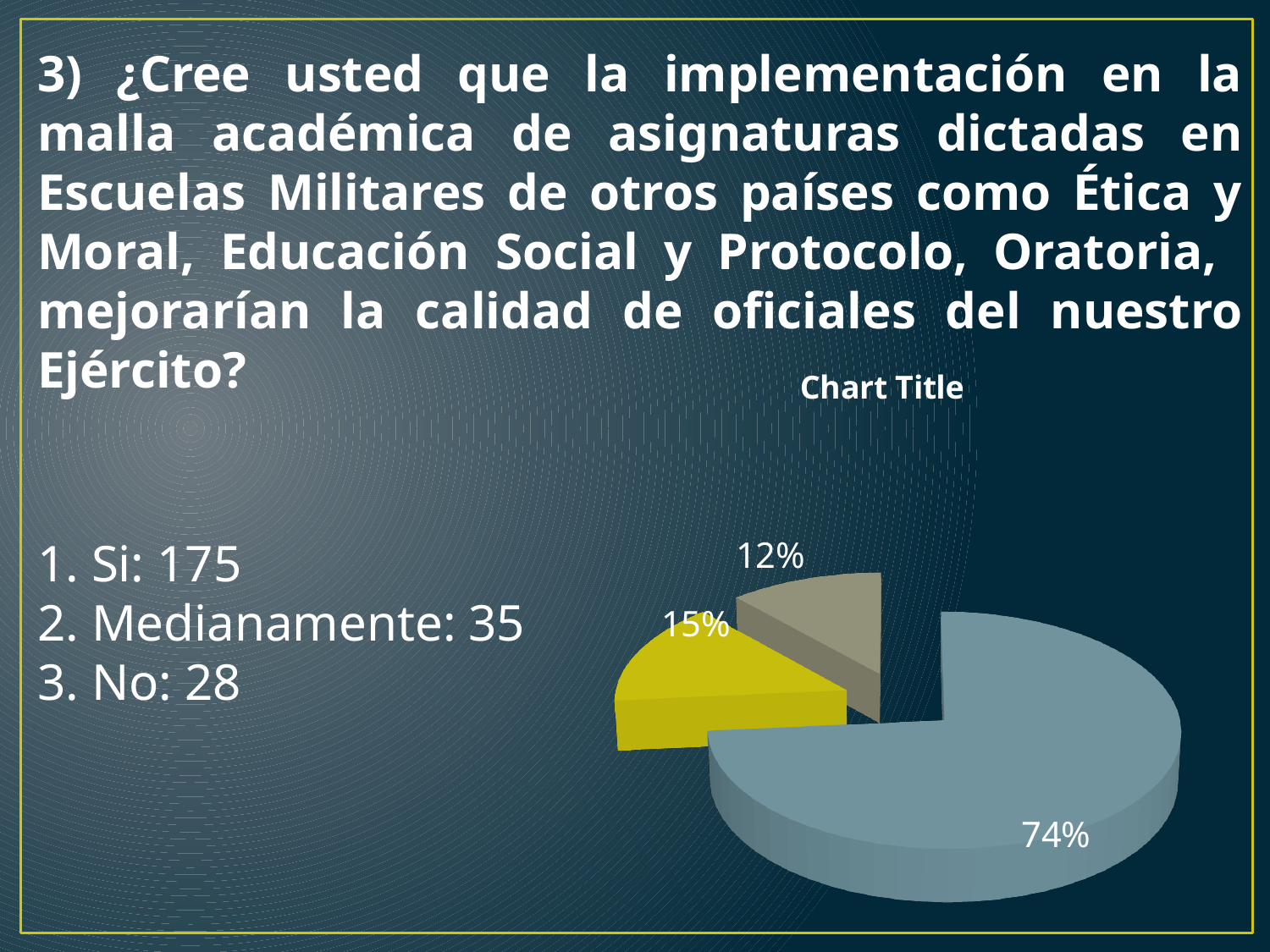
What colour is the largest slice of the pie chart? blue Which slice is larger, the yellow slice or the grey slice? yellow slice How many slices does the pie chart have? 3 What is the title of the chart? Chart Title What is the share of the smallest slice of the pie chart? 12% What is the difference in percentage points between the largest slice (74%) and the smallest slice (12%)? 62 What is the share of the grey slice of the pie chart? 12% What kind of chart is shown on the slide? pie chart What is the share of the blue slice of the pie chart? 74% What is the difference in percentage points between the yellow slice (15%) and the grey slice (12%)? 3 What is the share of the yellow slice of the pie chart? 15% What is the share of the largest slice of the pie chart? 74%